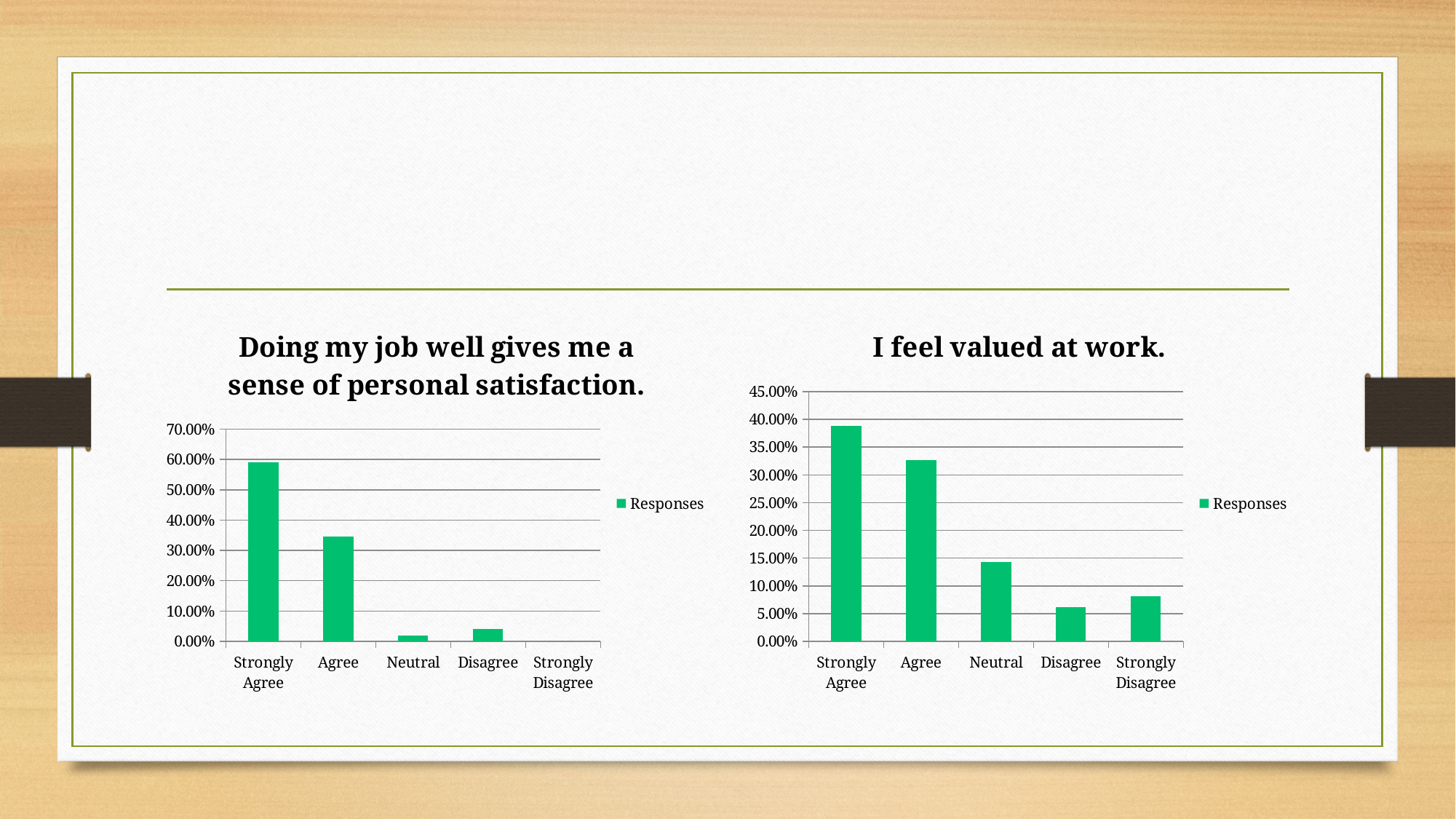
What is the legend entry shown in the chart titled "I feel valued at work."? Responses How many series does the legend list in the chart titled "I feel valued at work."? 1 In the chart titled "I feel valued at work.", is the value for Neutral greater or less than 10.00%? greater In the chart titled "Doing my job well gives me a sense of personal satisfaction.", which is larger, the value for Strongly Agree or the value for Agree? Strongly Agree In the chart titled "I feel valued at work.", which is larger, the value for Neutral or the value for Disagree? Neutral In the chart titled "Doing my job well gives me a sense of personal satisfaction.", which category has the lowest value? Strongly Disagree In the chart titled "I feel valued at work.", which category has the highest value? Strongly Agree In the chart titled "I feel valued at work.", is the value for Strongly Agree greater or less than 40.00%? less In the chart titled "Doing my job well gives me a sense of personal satisfaction.", which category has the highest value? Strongly Agree What kind of chart is the chart titled "I feel valued at work."? bar chart In the chart titled "Doing my job well gives me a sense of personal satisfaction.", is the value for Strongly Agree greater or less than 50.00%? greater How many categories are shown on the x axis of the chart titled "Doing my job well gives me a sense of personal satisfaction."? 5